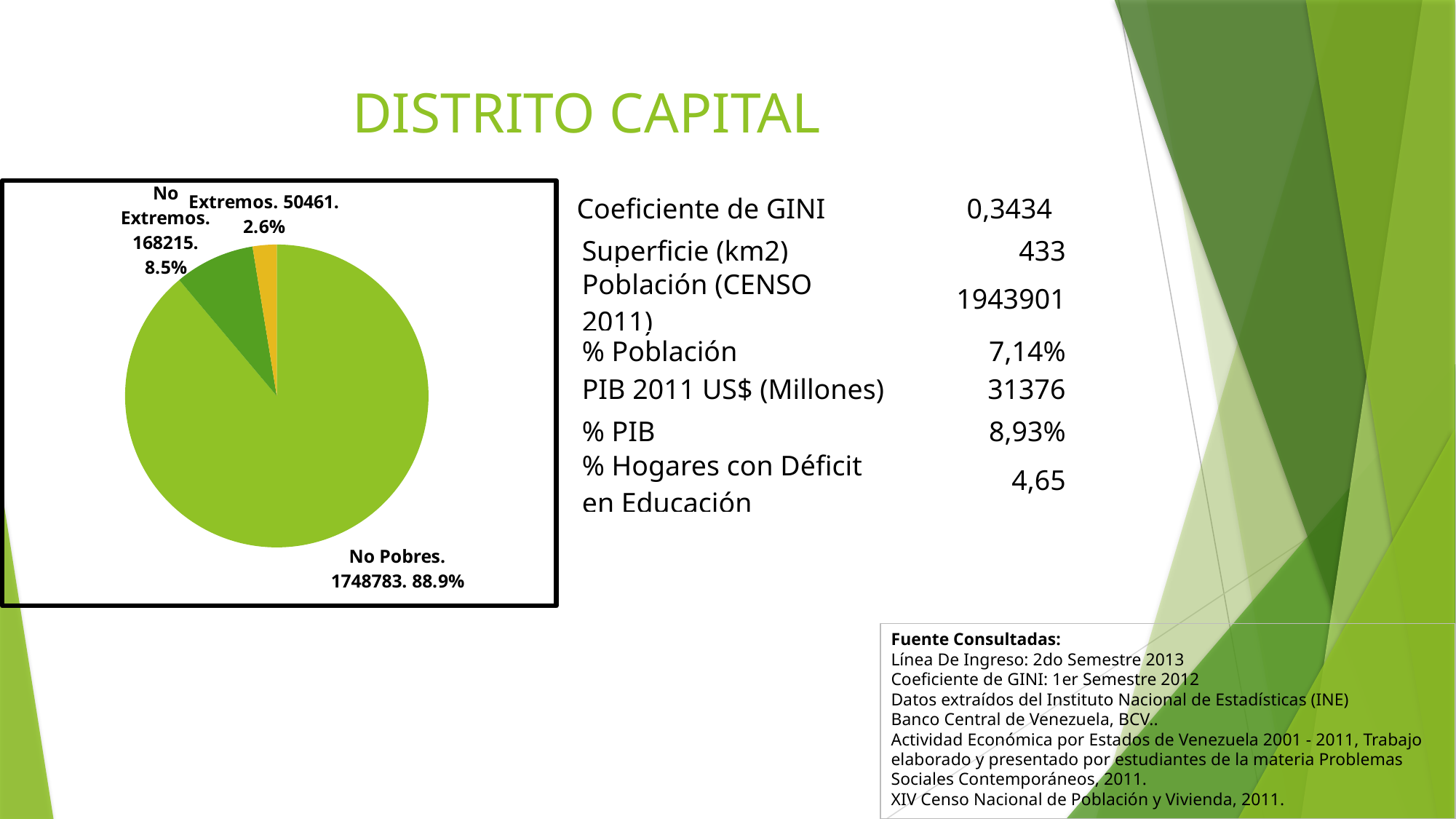
What share of the pie does the Extremos slice represent? 2.6% Which slice of the pie chart is the smallest? Extremos What kind of chart is shown on the slide? pie chart What is the value shown for the No Extremos slice of the pie chart? 168215 How many slices does the pie chart have? 3 What is the value shown for the Extremos slice of the pie chart? 50461 What is the value shown for the No Pobres slice of the pie chart? 1748783 What share of the pie does the No Extremos slice represent? 8.5% What share of the pie does the No Pobres slice represent? 88.9% Which is larger in the pie chart, No Extremos or Extremos? No Extremos What is the difference between the No Extremos value and the Extremos value in the pie chart? 117754 Which slice of the pie chart is the largest? No Pobres